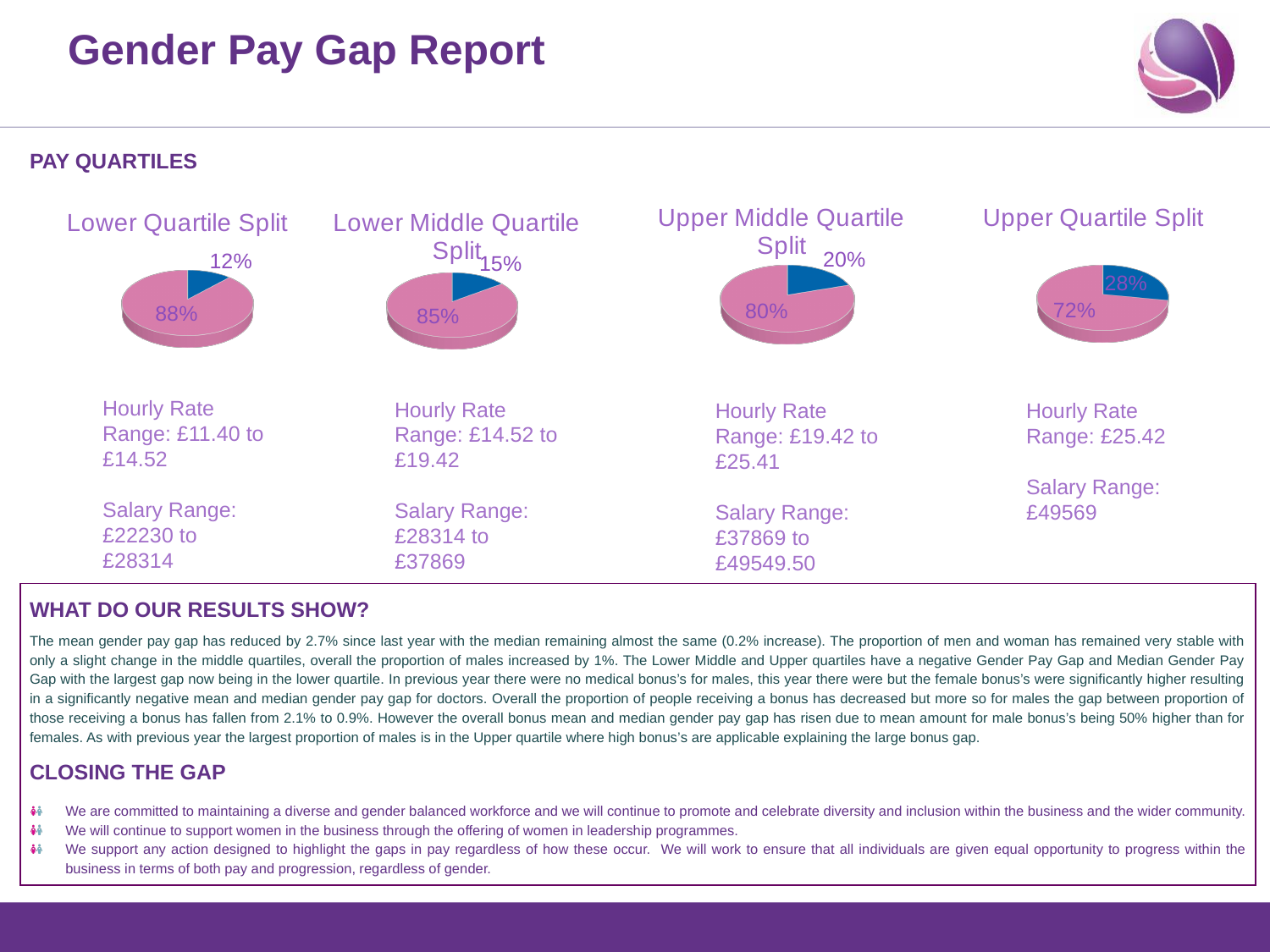
Which of the four pie charts has the smallest blue slice? Lower Quartile Split In the Lower Quartile Split chart, what percentage does the smaller (blue) slice show? 12% How many pie charts are shown in the Pay Quartiles section of the slide? 4 In the Lower Middle Quartile Split chart, what percentage does the blue slice show? 15% In the Lower Quartile Split chart, what percentage does the larger (pink) slice show? 88% How many slices does the Lower Middle Quartile Split pie chart have? 2 In the Upper Middle Quartile Split chart, what percentage does the pink slice show? 80% In the Upper Quartile Split chart, what is the difference between the pink slice and the blue slice? 44% In the Upper Quartile Split chart, what percentage does the blue slice show? 28% Which chart has the larger blue slice: the Lower Quartile Split or the Upper Middle Quartile Split? Upper Middle Quartile Split Across the four pie charts from Lower Quartile to Upper Quartile, does the blue slice's percentage rise or fall? Rise What kind of chart is the Upper Quartile Split chart? Pie chart